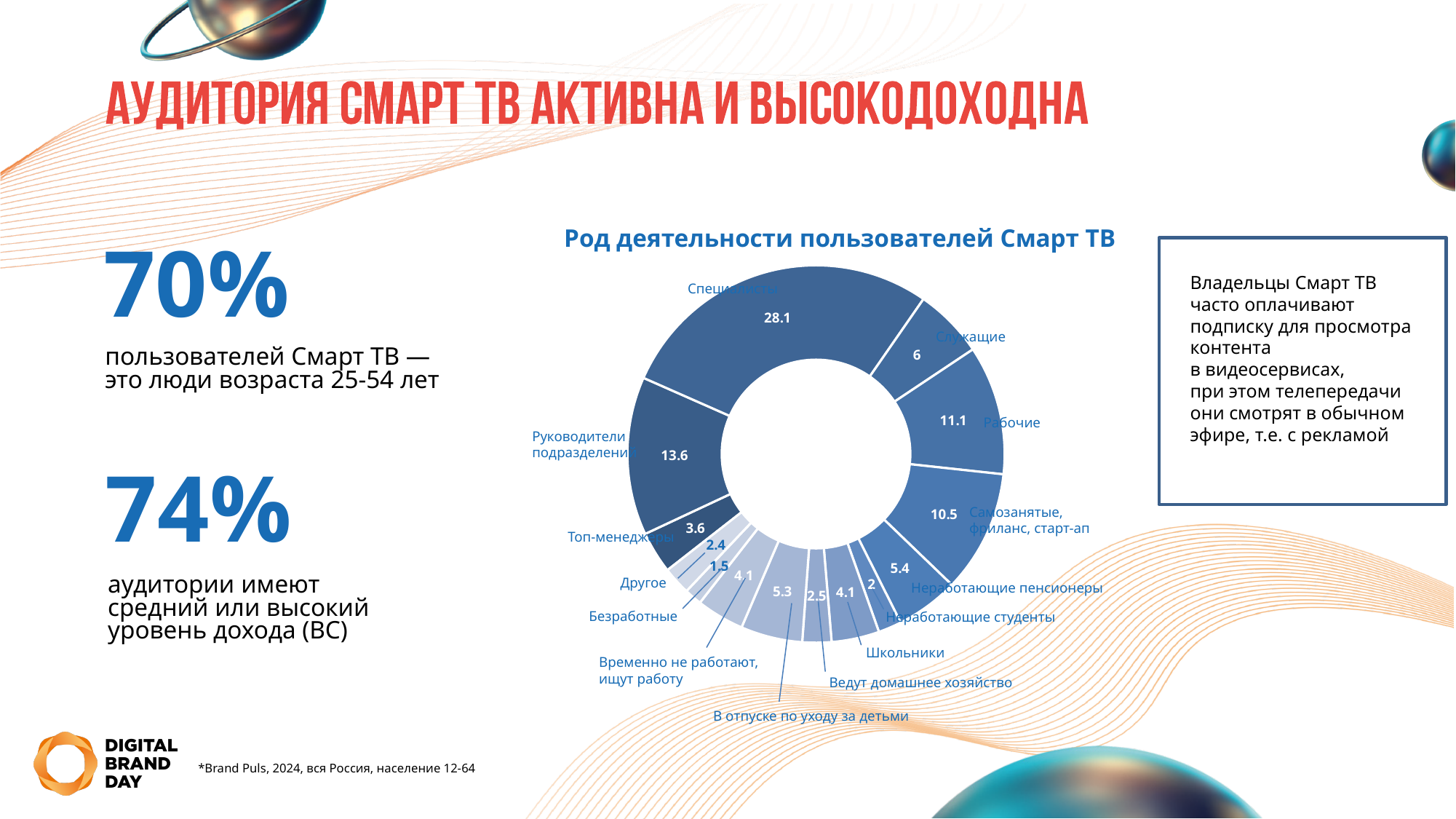
What is the value for Школьники? 4.1 What is the value for Рабочие? 11.1 How many categories are shown in the chart? 14 What is the title of the chart? Род деятельности пользователей Смарт ТВ What is the value for Самозанятые, фриланс, старт-ап? 10.5 What is the value for Руководители подразделений? 13.6 Which category has the smallest value in the chart? Безработные Which is larger, the value for Служащие or the value for Топ-менеджеры? Служащие Which category has the largest share of the chart? Специалисты What is the difference between the values for Специалисты and Руководители подразделений? 14.5 What is the value for Неработающие пенсионеры? 5.4 What kind of chart is shown on the slide? Doughnut (pie) chart